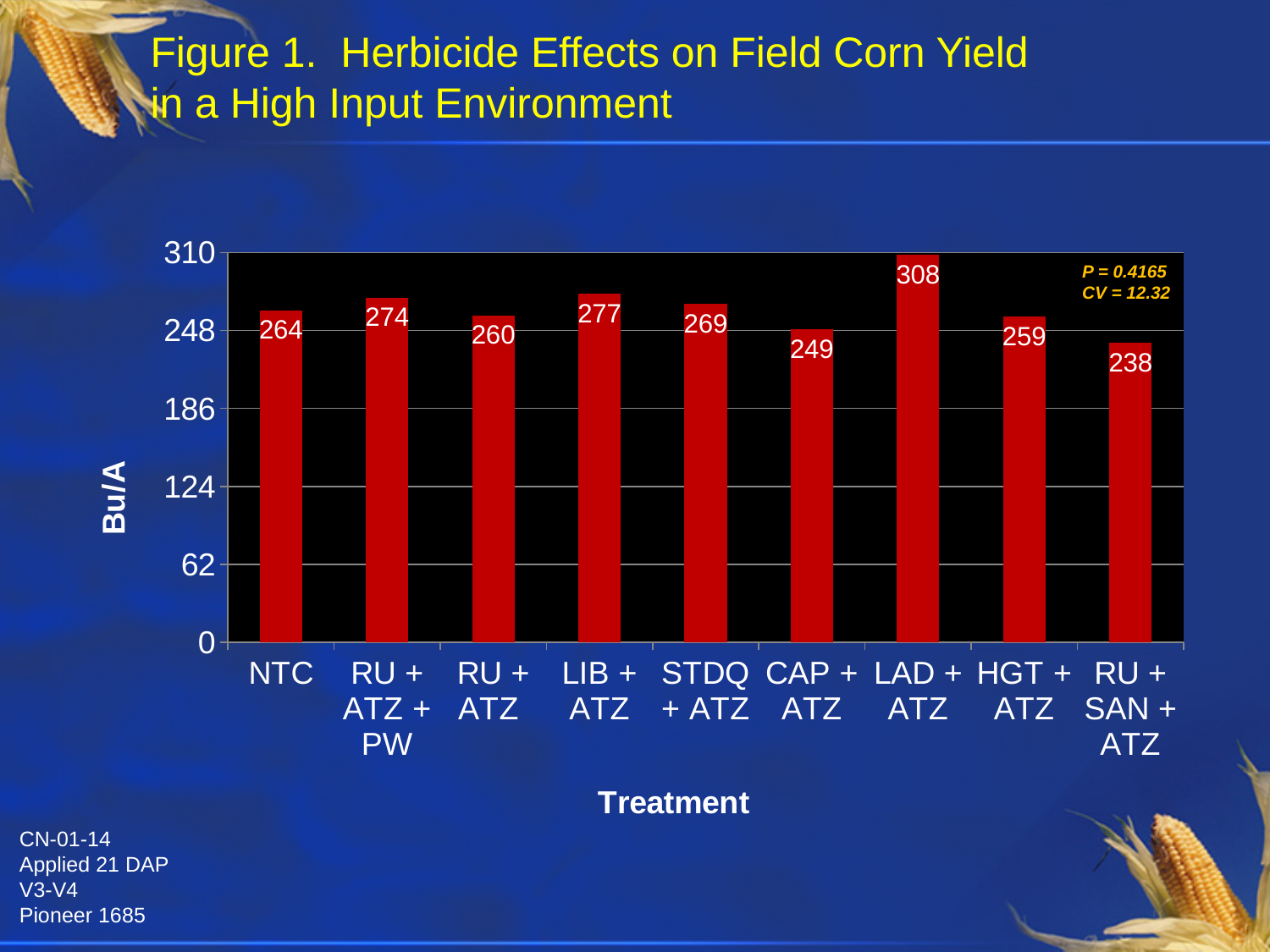
Which treatment has the lowest yield? RU + SAN + ATZ What kind of chart is shown on the slide? Bar chart What is the yield in Bu/A for the LIB + ATZ treatment? 277 Which treatment has the highest yield? LAD + ATZ What is the yield in Bu/A for the RU + SAN + ATZ treatment? 238 Is the yield for CAP + ATZ greater or less than 248? greater What is the difference in yield between LAD + ATZ and CAP + ATZ? 59 What is the yield in Bu/A for the NTC treatment? 264 What is the difference in yield between RU + ATZ + PW and RU + ATZ? 14 What is the label on the y axis of the chart? Bu/A Which has a higher yield, STDQ + ATZ or HGT + ATZ? STDQ + ATZ How many treatments are shown on the chart? 9